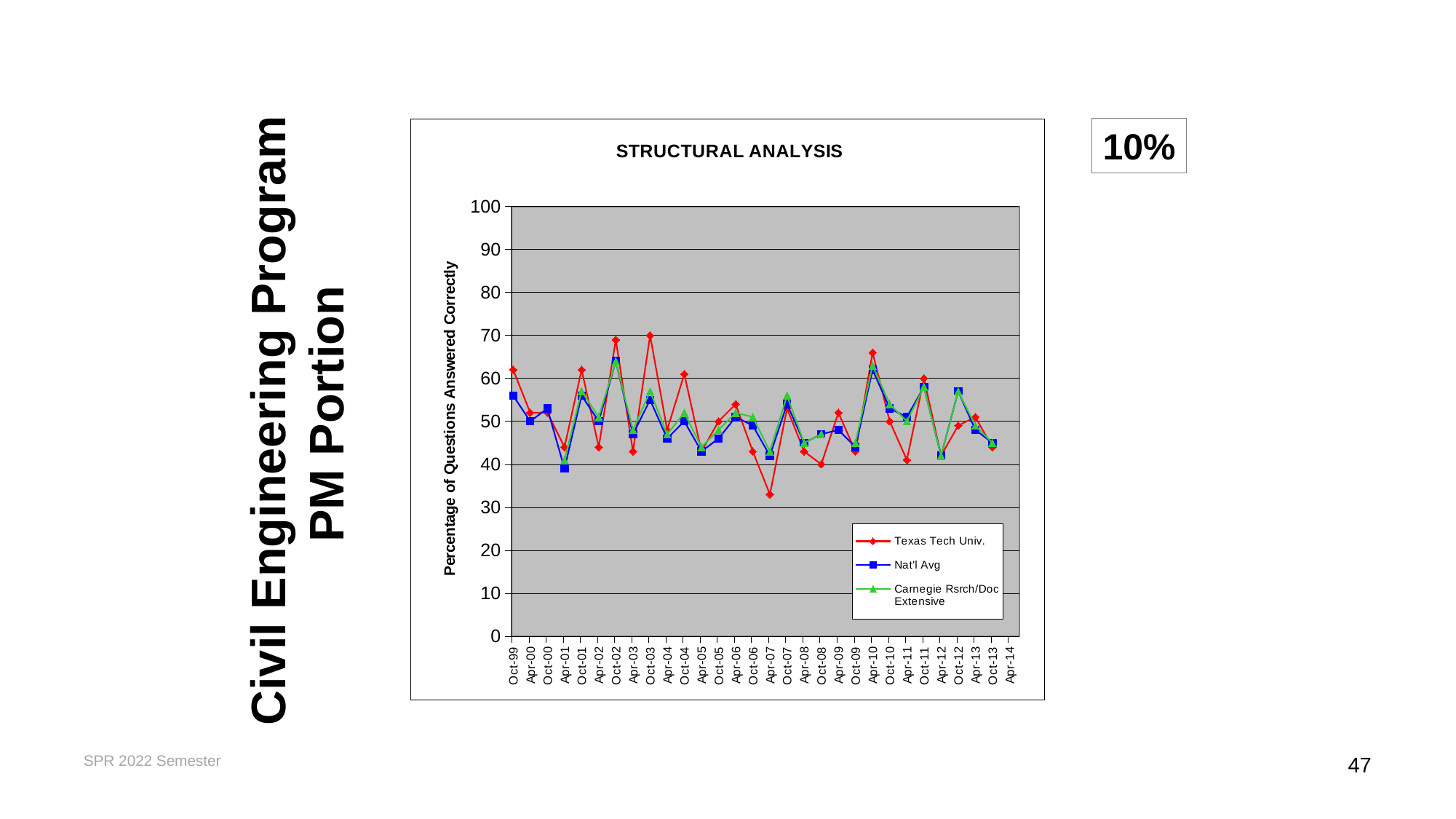
What kind of chart is shown on the slide? Line chart How many series does the legend list? 3 At which date does the Texas Tech Univ. series reach its lowest value? Apr-07 Is the Texas Tech Univ. value at Apr-10 greater or less than 60? greater How many date labels are shown along the x axis? 30 At Apr-07, which is larger: the Texas Tech Univ. value or the Nat'l Avg value? Nat'l Avg What is the title of the chart? STRUCTURAL ANALYSIS Is the Texas Tech Univ. value at Apr-07 greater or less than 40? less What is the label on the vertical axis of the chart? Percentage of Questions Answered Correctly Is the Nat'l Avg value at Oct-02 greater or less than 60? greater At Oct-03, which is larger: the Texas Tech Univ. value or the Nat'l Avg value? Texas Tech Univ.